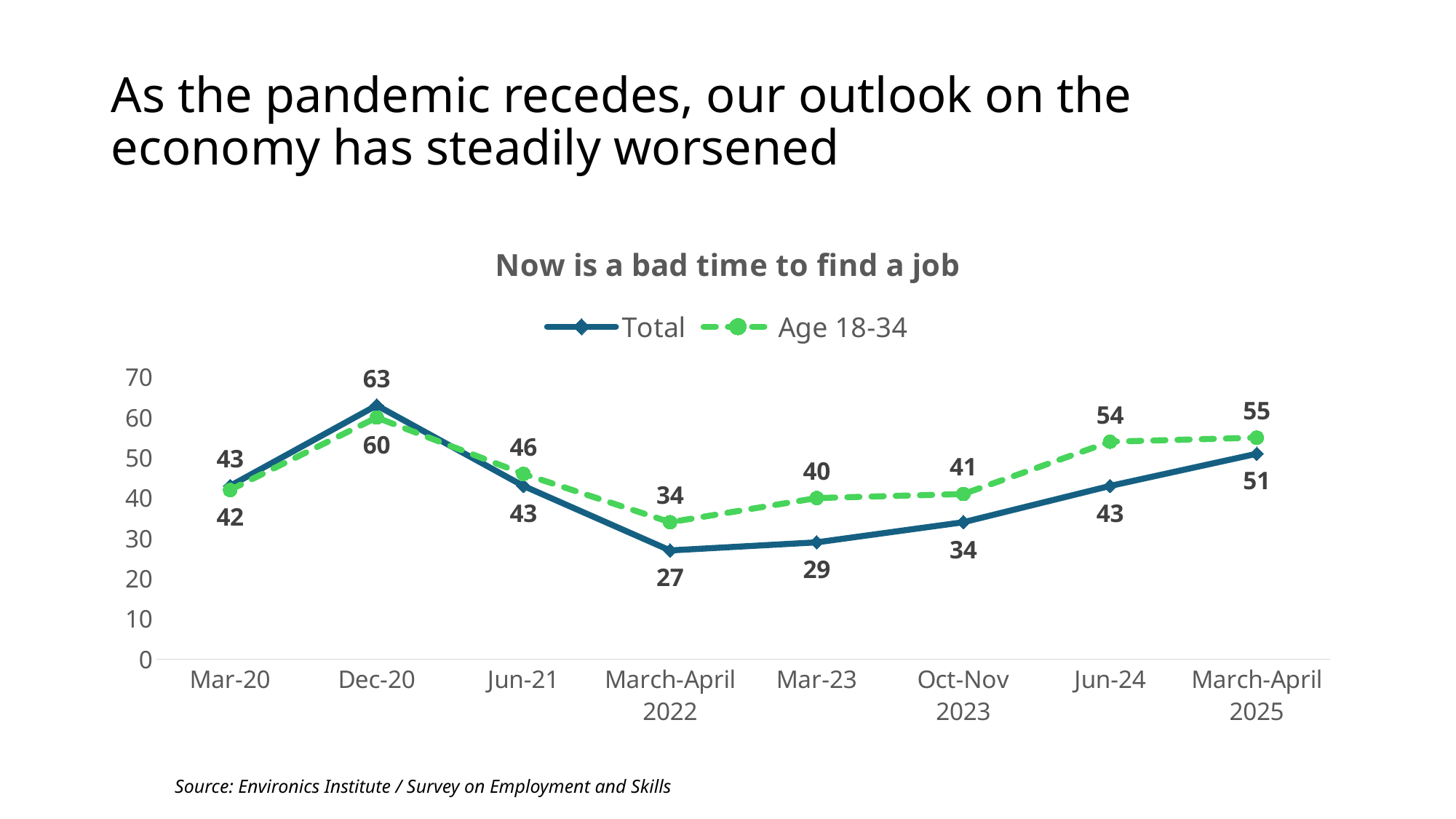
What kind of chart is shown? Line chart Does the Total series rise or fall from March-April 2022 to March-April 2025? Rise At which time point is the Age 18-34 series lowest? March-April 2022 What is the value for Total in Dec-20? 63 What is the value for Total in March-April 2022? 27 What is the difference between Age 18-34 and Total in Jun-24? 11 How many time points are plotted on the x axis? 8 How many series does the legend list? 2 What is the title of the chart? Now is a bad time to find a job What is the value for Age 18-34 in March-April 2025? 55 Which is larger in Mar-23: Total or Age 18-34? Age 18-34 At which time point is the Total series highest? Dec-20